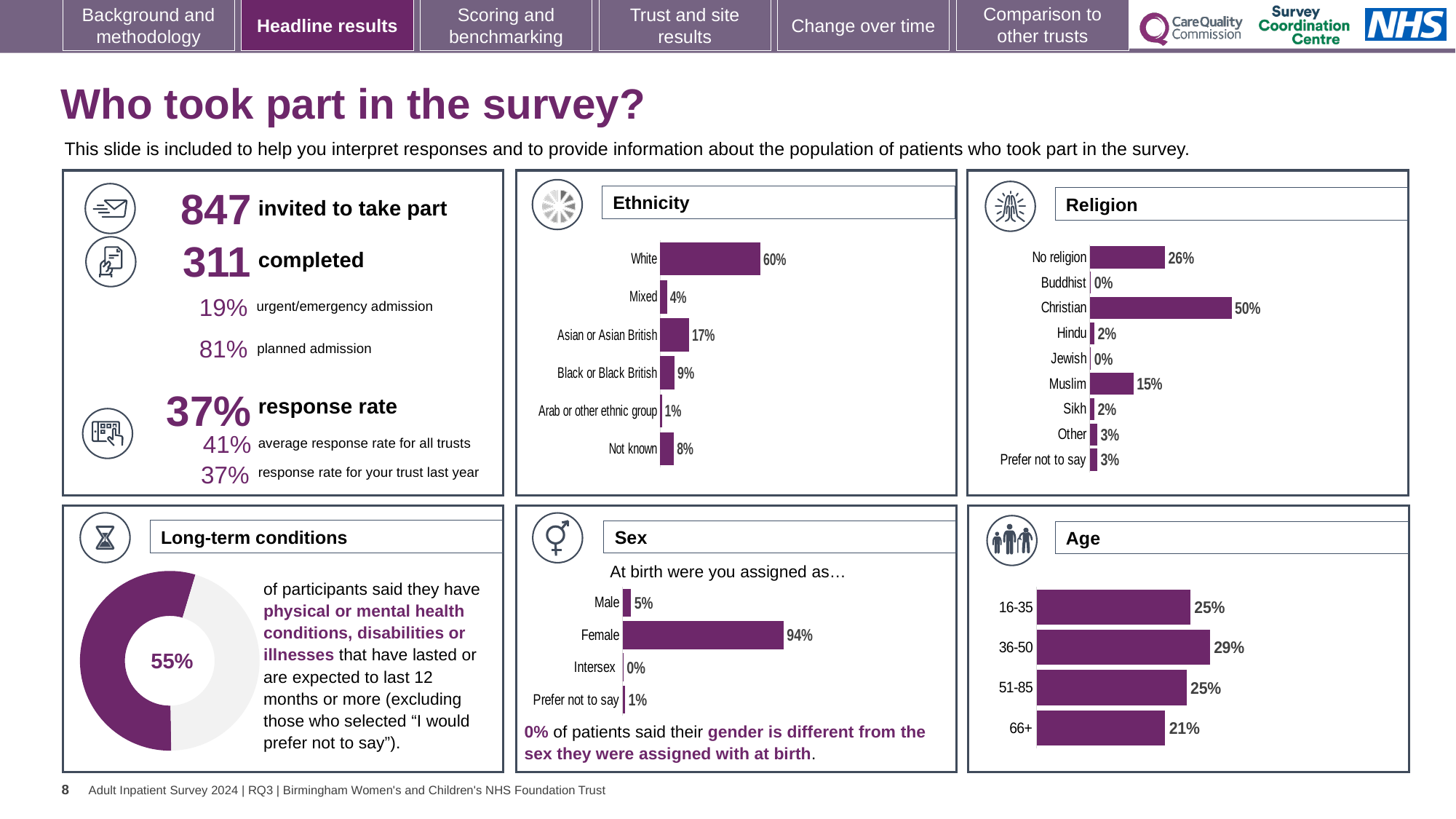
In the Religion chart, which religion has the highest percentage? Christian In the Age chart, which age group has the highest percentage? 36-50 In the Religion chart, how many categories are shown? 9 In the Sex chart, what percentage of participants were assigned Female at birth? 94% What kind of chart is used in the Long-term conditions panel? Doughnut chart In the Sex chart, what is the difference between Female and Male? 89% In the Ethnicity chart, what is the difference between Asian or Asian British and Black or Black British? 8% In the Religion chart, what percentage of participants were Muslim? 15% In the Ethnicity chart, which category has the lowest value? Arab or other ethnic group In the Age chart, what percentage of participants were aged 66+? 21% In the Ethnicity chart, what percentage of participants were White? 60% In the Religion chart, is the value for No religion larger or smaller than the value for Muslim? larger